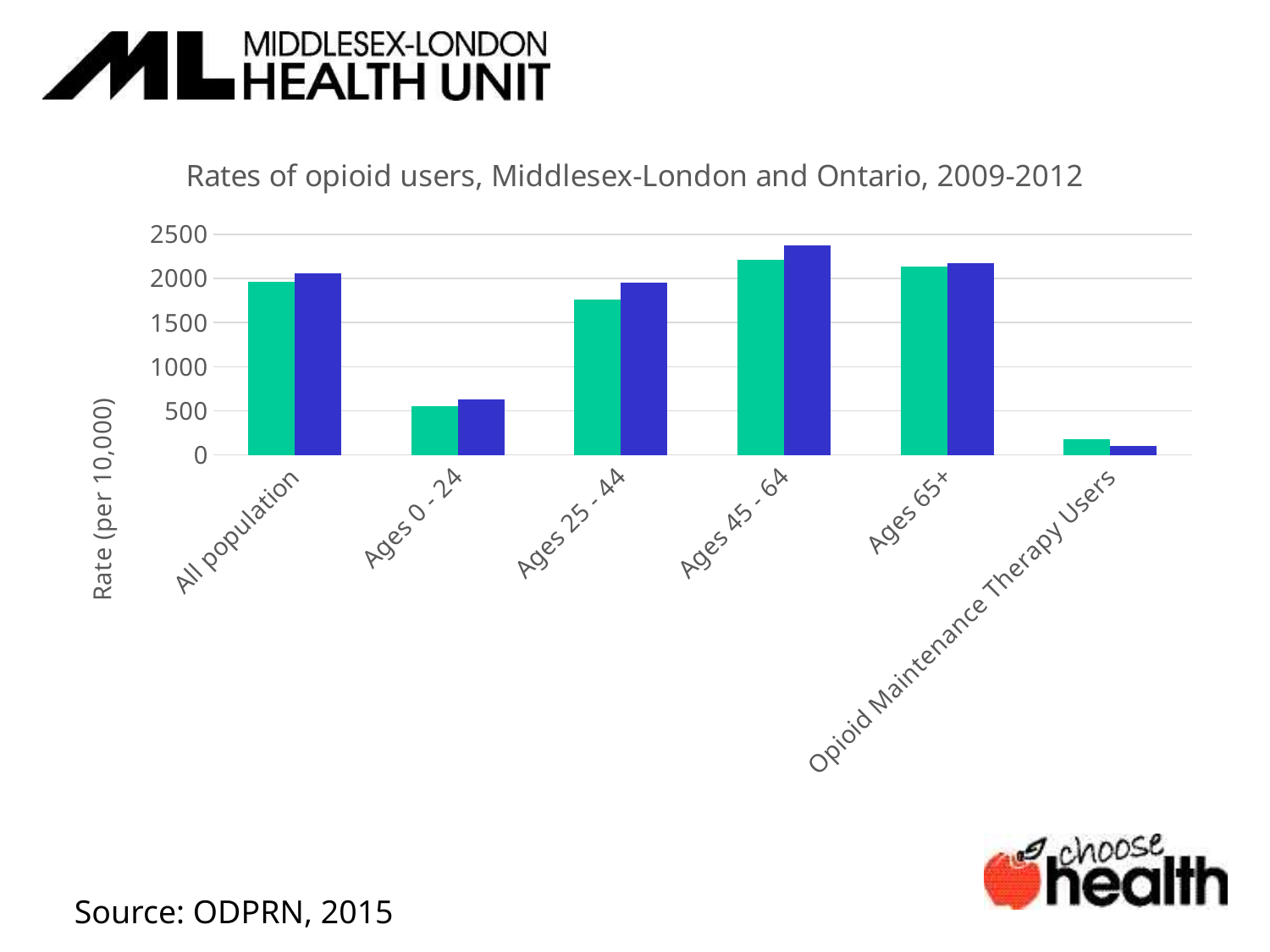
How many categories are shown on the x axis of the chart? 6 Which category has the lowest rate in the chart? Opioid Maintenance Therapy Users Which category has the highest rate in the chart? Ages 45 - 64 Is the blue bar for Opioid Maintenance Therapy Users greater or less than 500? less Is the blue bar for Ages 45 - 64 greater or less than 2000? greater What is the title of the chart? Rates of opioid users, Middlesex-London and Ontario, 2009-2012 Is the teal bar for Ages 25 - 44 greater or less than 2000? less What is the label on the vertical axis of the chart? Rate (per 10,000) What kind of chart is shown on the slide? bar chart For Ages 25 - 44, which bar is larger, the teal bar or the blue bar? the blue bar Which is larger, the teal bar for Ages 45 - 64 or the teal bar for Ages 0 - 24? Ages 45 - 64